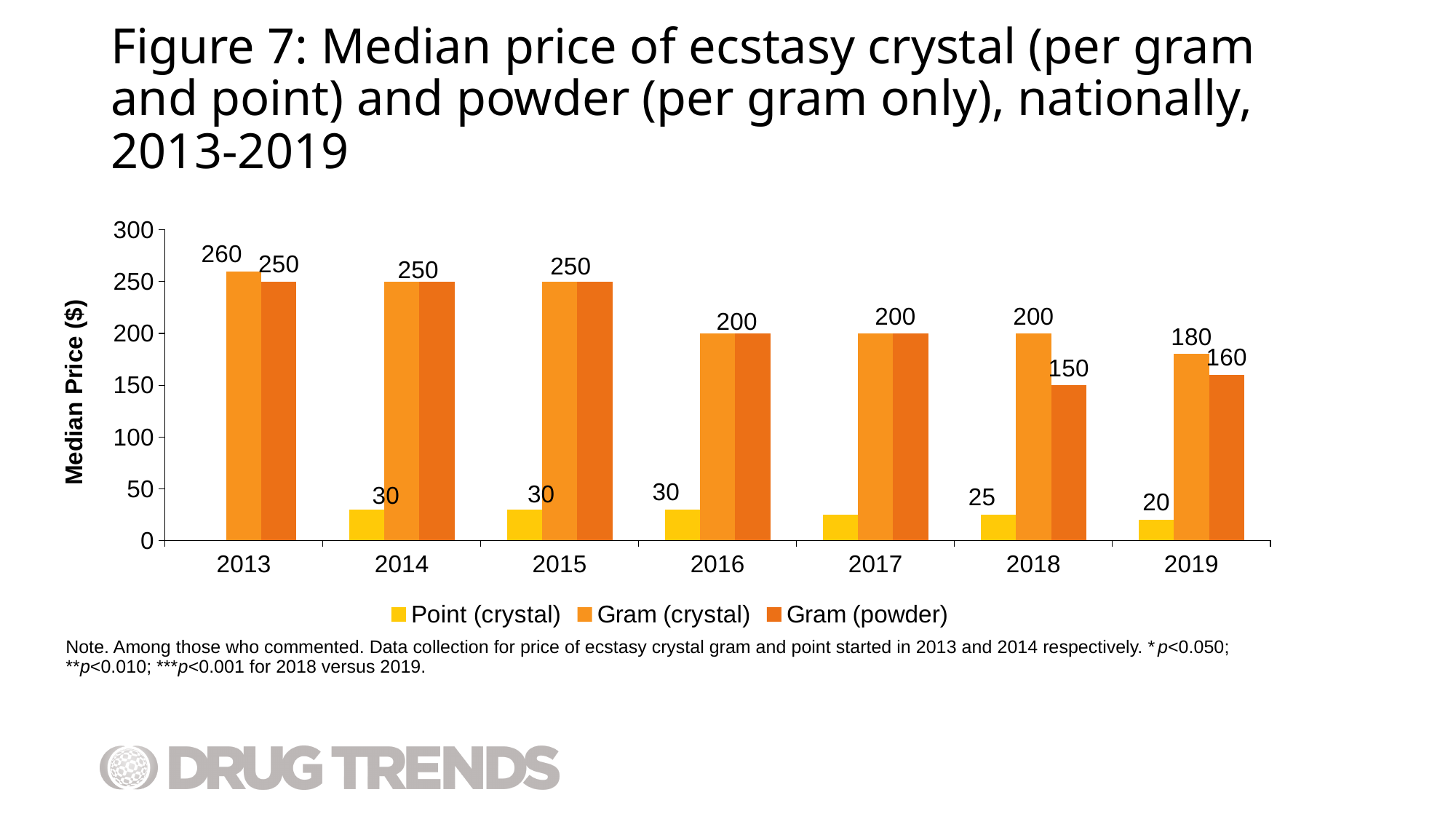
What is the median price for Gram (crystal) in 2019? 180 In which year is the Gram (crystal) median price highest? 2013 In 2019, what is the difference between the Gram (crystal) and Gram (powder) median prices? 20 How many series does the legend list? 3 In 2013, which is higher: Gram (crystal) or Gram (powder)? Gram (crystal) What kind of chart is shown on the slide? Bar chart In 2018, how much higher is the Gram (crystal) median price than the Gram (powder) median price? 50 In which year is the Point (crystal) median price lowest? 2019 What is the median price for Gram (powder) in 2018? 150 What is the median price for Gram (crystal) in 2013? 260 What is the median price for Point (crystal) in 2019? 20 Does the Gram (crystal) median price rise or fall from 2013 to 2019? Fall